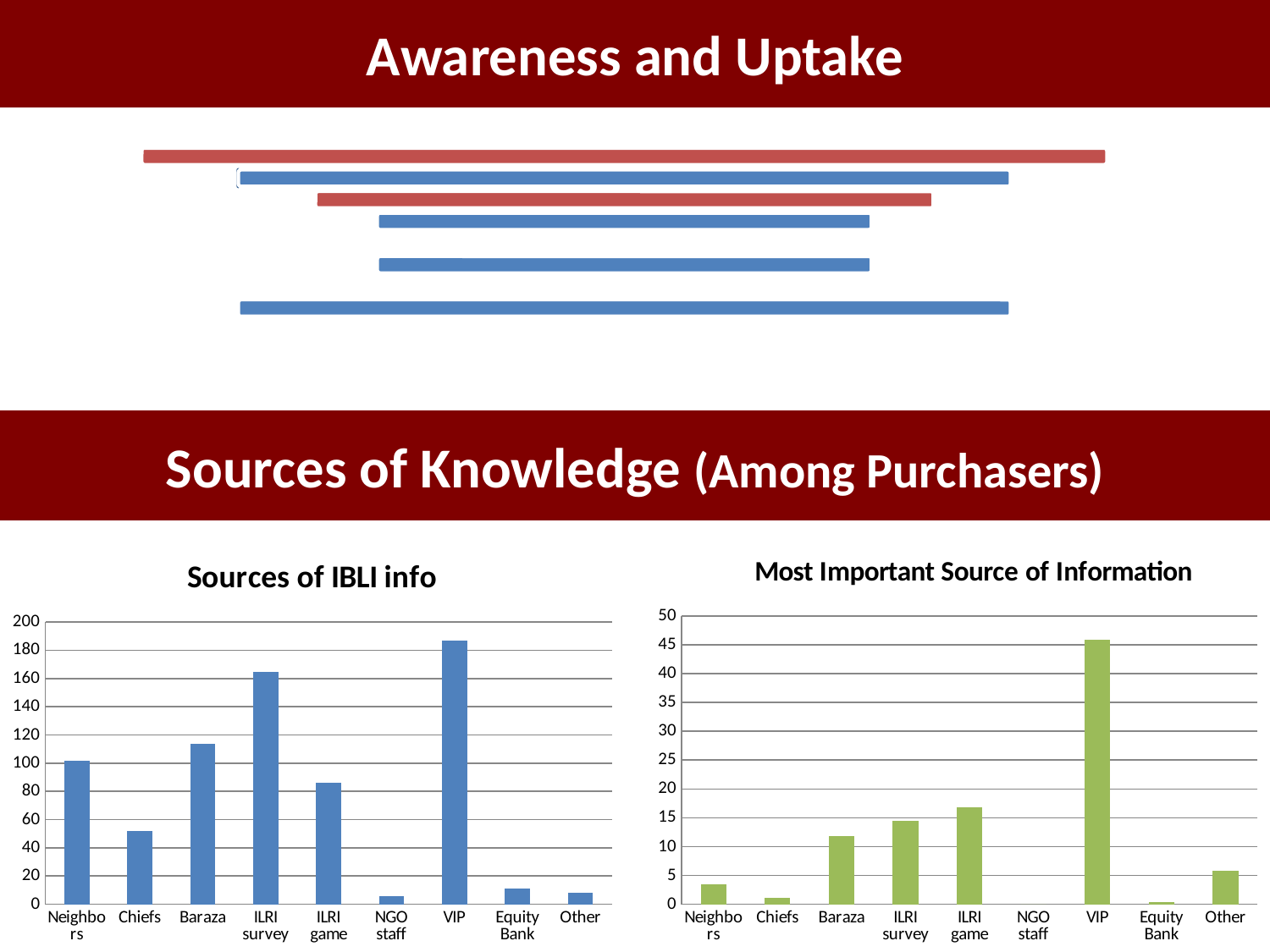
In the 'Most Important Source of Information' chart, which category has the highest value? VIP How many categories are shown on the x axis of the 'Sources of IBLI info' chart? 9 What colour are the bars in the 'Most Important Source of Information' chart? green In the 'Most Important Source of Information' chart, is the value for Baraza greater or less than 10? greater What kind of chart is 'Most Important Source of Information'? bar chart In the 'Sources of IBLI info' chart, which is larger, ILRI survey or Baraza? ILRI survey In the 'Sources of IBLI info' chart, is the value for Chiefs greater or less than 60? less In the 'Most Important Source of Information' chart, is the value for VIP greater or less than 40? greater In the 'Sources of IBLI info' chart, which category has the highest value? VIP In the 'Most Important Source of Information' chart, which is larger, ILRI game or Baraza? ILRI game